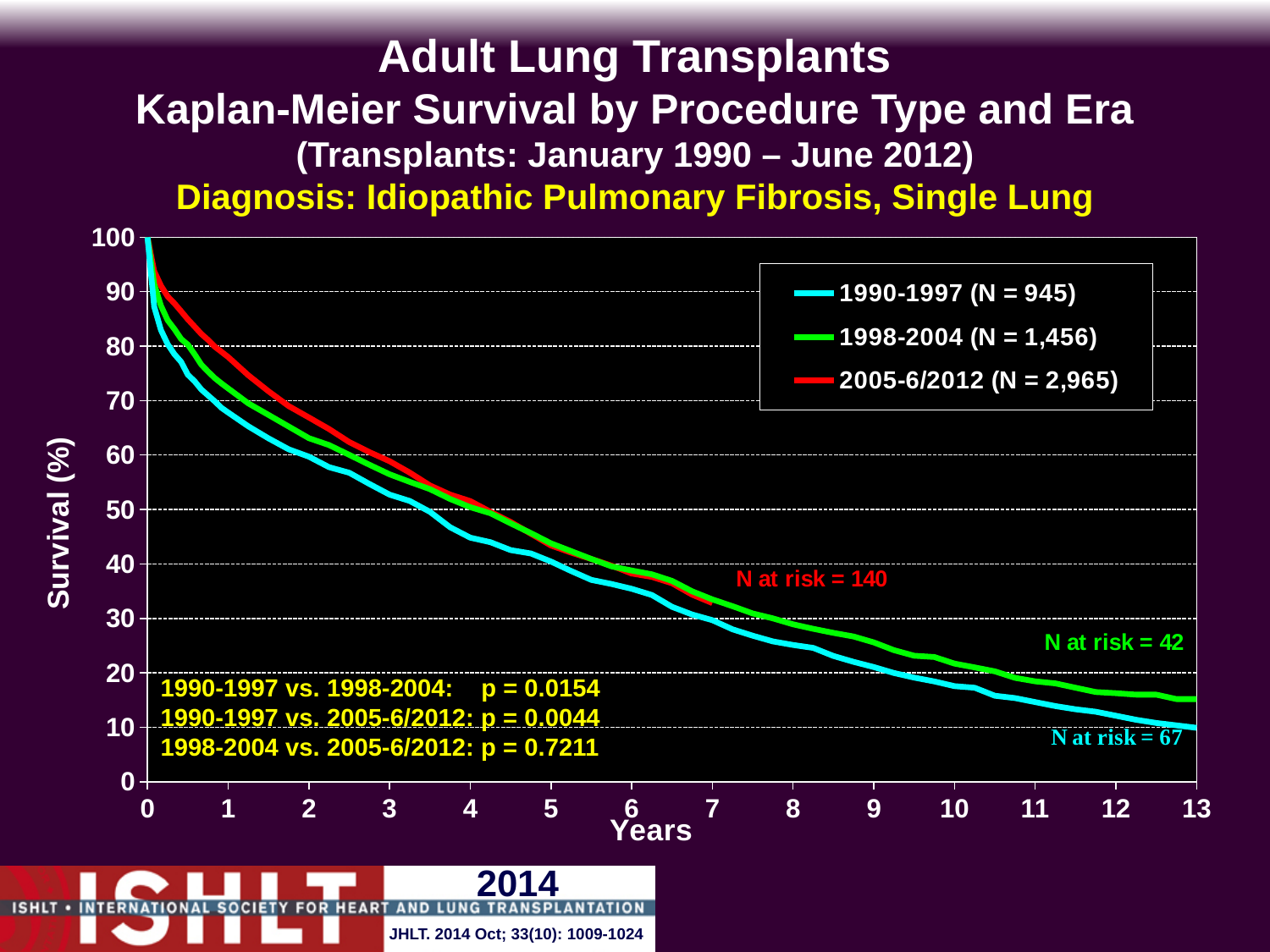
What is the N for the 1990-1997 era shown in the legend? 945 How many series does the legend list? 3 What is the label of the y axis? Survival (%) What is the N for the 1998-2004 era shown in the legend? 1,456 What kind of chart is shown on the slide? line chart At year 1, which curve is higher: 1990-1997 or 2005-6/2012? 2005-6/2012 What is the N at risk shown for the 1998-2004 curve? 42 Is the survival value for the 1990-1997 curve at year 10 greater or less than 20? less What is the N at risk shown for the 2005-6/2012 curve? 140 Do the survival curves rise or fall as years increase? fall Which era has the largest N in the legend? 2005-6/2012 What p-value is shown for 1990-1997 vs. 2005-6/2012? 0.0044